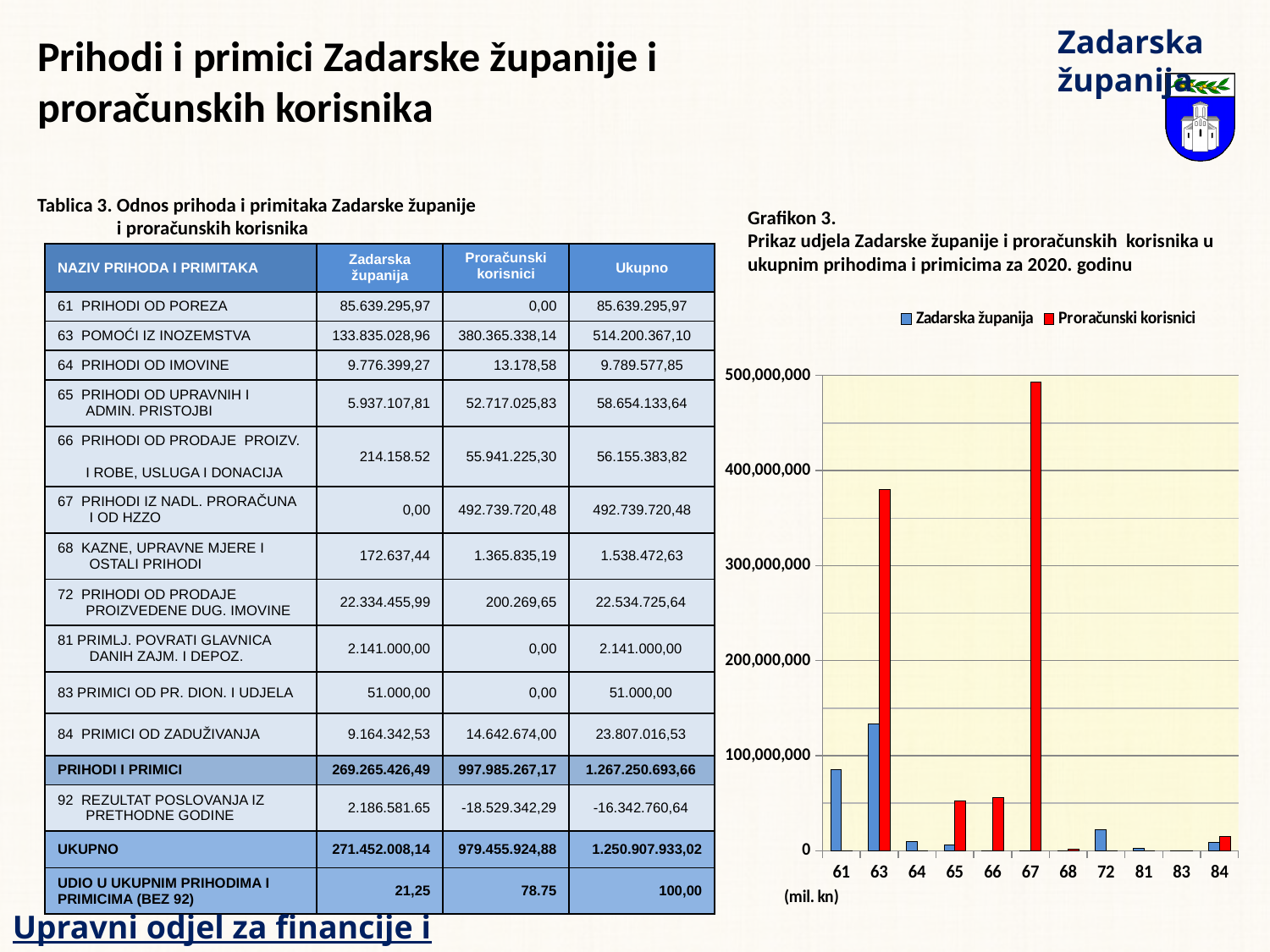
What kind of chart is Grafikon 3? bar chart Is the Zadarska županija value for category 63 greater or less than 100,000,000? greater How many series does the chart's legend list? 2 Which category has the highest value for the Proračunski korisnici series? 67 How many categories are shown on the x axis of the chart? 11 Which category has the highest value for the Zadarska županija series? 63 Is the Zadarska županija value for category 61 greater or less than 100,000,000? less Is the Proračunski korisnici value for category 63 greater or less than 400,000,000? less What colour are the bars for the Proračunski korisnici series? red For category 63, which series has the larger value, Zadarska županija or Proračunski korisnici? Proračunski korisnici For category 61, which series has the larger value, Zadarska županija or Proračunski korisnici? Zadarska županija